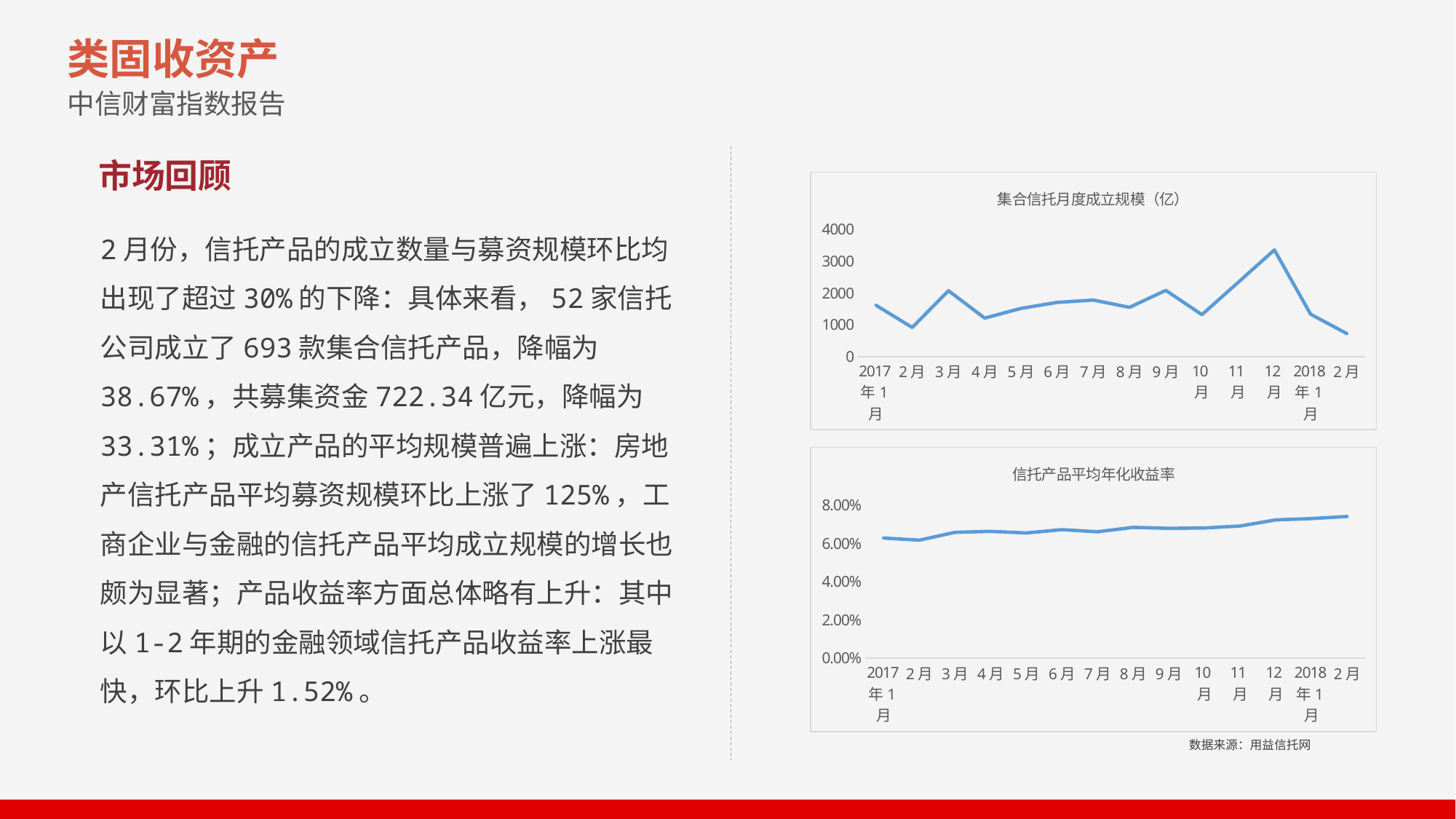
What kind of chart is the bottom chart titled 信托产品平均年化收益率? line chart What kind of chart is the top chart titled 集合信托月度成立规模（亿）? line chart In the top chart 集合信托月度成立规模（亿）, is the value for 12月 greater or less than 3000? greater In the bottom chart 信托产品平均年化收益率, is the value for 2017年1月 greater or less than 6.00%? greater In the top chart 集合信托月度成立规模（亿）, is the value for 2017年1月 greater or less than 1000? greater In the bottom chart 信托产品平均年化收益率, do the values generally rise or fall from 2017年1月 to 2018年2月? rise In the top chart 集合信托月度成立规模（亿）, which is larger, the value for 3月 or the value for 4月? 3月 What is the title of the top chart on the slide? 集合信托月度成立规模（亿） In the bottom chart 信托产品平均年化收益率, which month has the highest value? 2018年2月 In the top chart 集合信托月度成立规模（亿）, which month has the highest value? 12月 In the top chart 集合信托月度成立规模（亿）, how many months are plotted along the x axis? 14